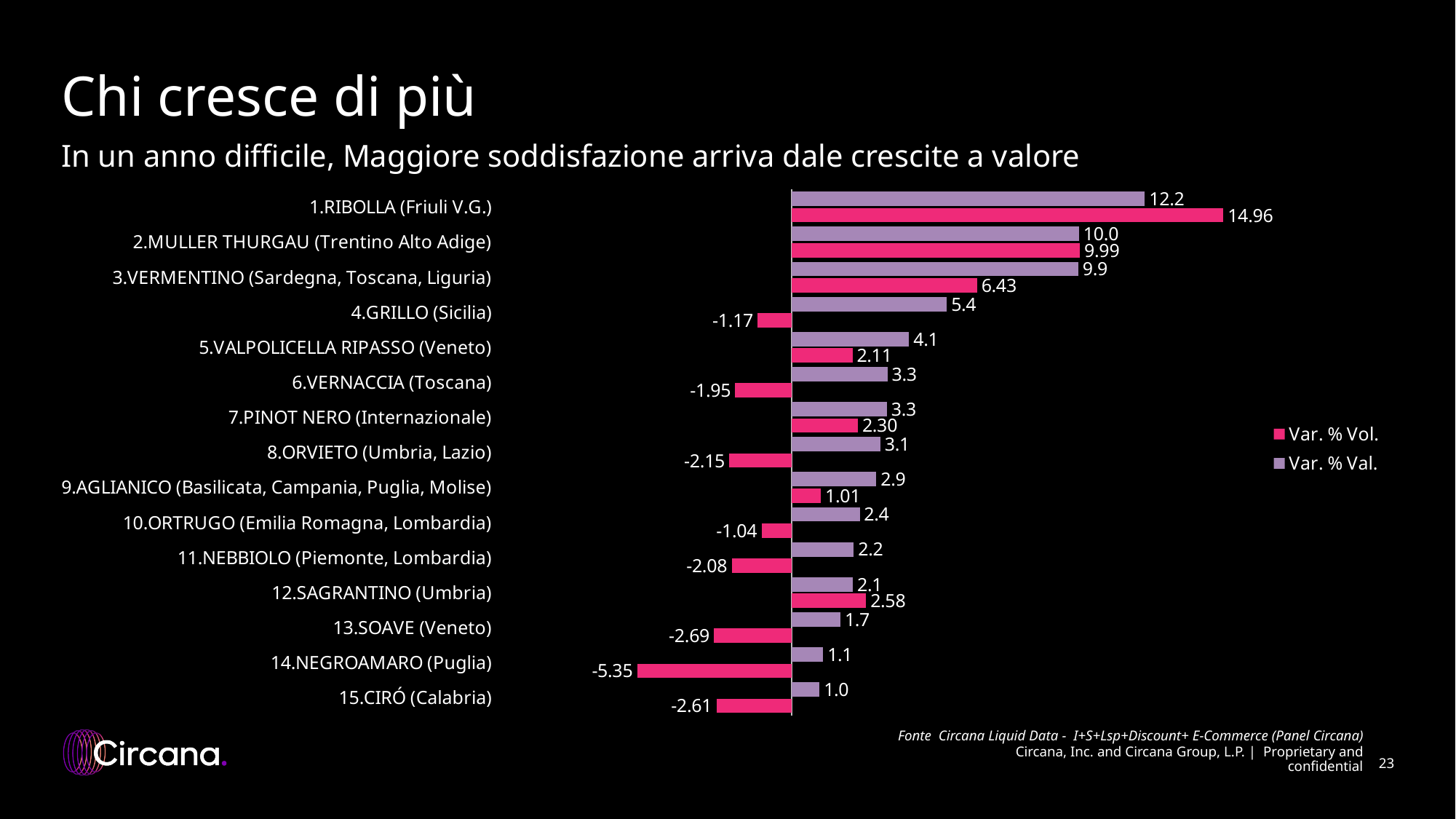
Which is larger for 12.SAGRANTINO (Umbria): the Var. % Vol. value or the Var. % Val. value? Var. % Vol. Which category has the lowest Var. % Vol. value? 14.NEGROAMARO (Puglia) Do the Var. % Val. values rise or fall going from the top category to the bottom category? Fall What is the Var. % Vol. value for 14.NEGROAMARO (Puglia)? -5.35 What is the Var. % Vol. value for 1.RIBOLLA (Friuli V.G.)? 14.96 What is the difference between the Var. % Val. and Var. % Vol. values for 3.VERMENTINO (Sardegna, Toscana, Liguria)? 3.47 What is the difference between the Var. % Vol. and Var. % Val. values for 1.RIBOLLA (Friuli V.G.)? 2.76 How many categories are shown in the chart? 15 Which category has the highest Var. % Val. value? 1.RIBOLLA (Friuli V.G.) What is the Var. % Val. value for 4.GRILLO (Sicilia)? 5.4 How many series does the legend list? 2 What kind of chart is shown on the slide? Bar chart